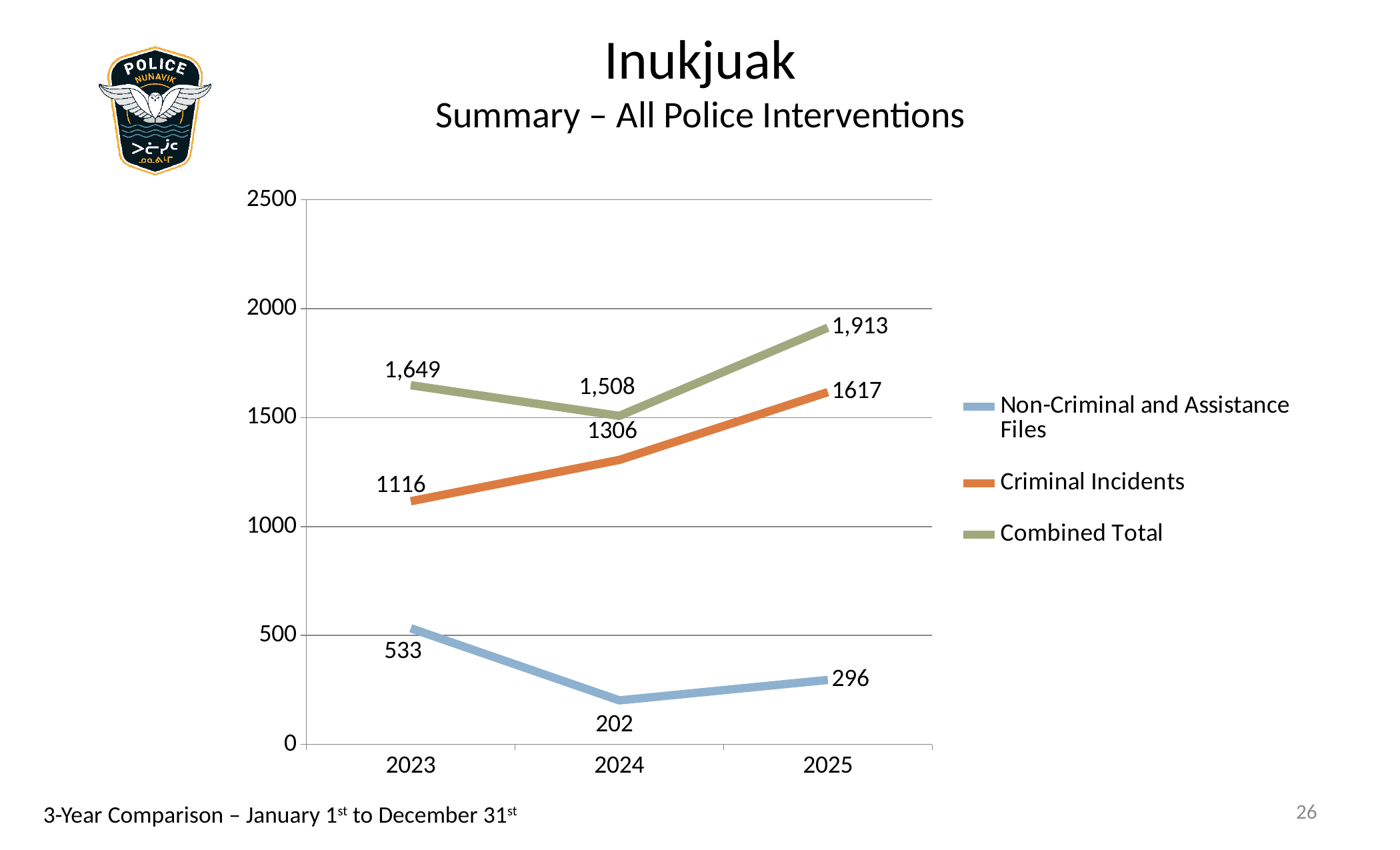
What kind of chart is shown on the slide? Line chart Is the Combined Total for 2023 greater or less than 1500? greater Which is larger: Non-Criminal and Assistance Files in 2023 or in 2025? 2023 What is the Combined Total for 2025? 1,913 What is the difference between Criminal Incidents in 2025 and 2023? 501 Do Criminal Incidents rise or fall from 2023 to 2025? Rise How many series does the legend list? 3 What is the value for Criminal Incidents in 2024? 1306 In which year are Criminal Incidents highest? 2025 How many years are shown on the x axis? 3 In which year is the Combined Total lowest? 2024 What is the value for Non-Criminal and Assistance Files in 2023? 533